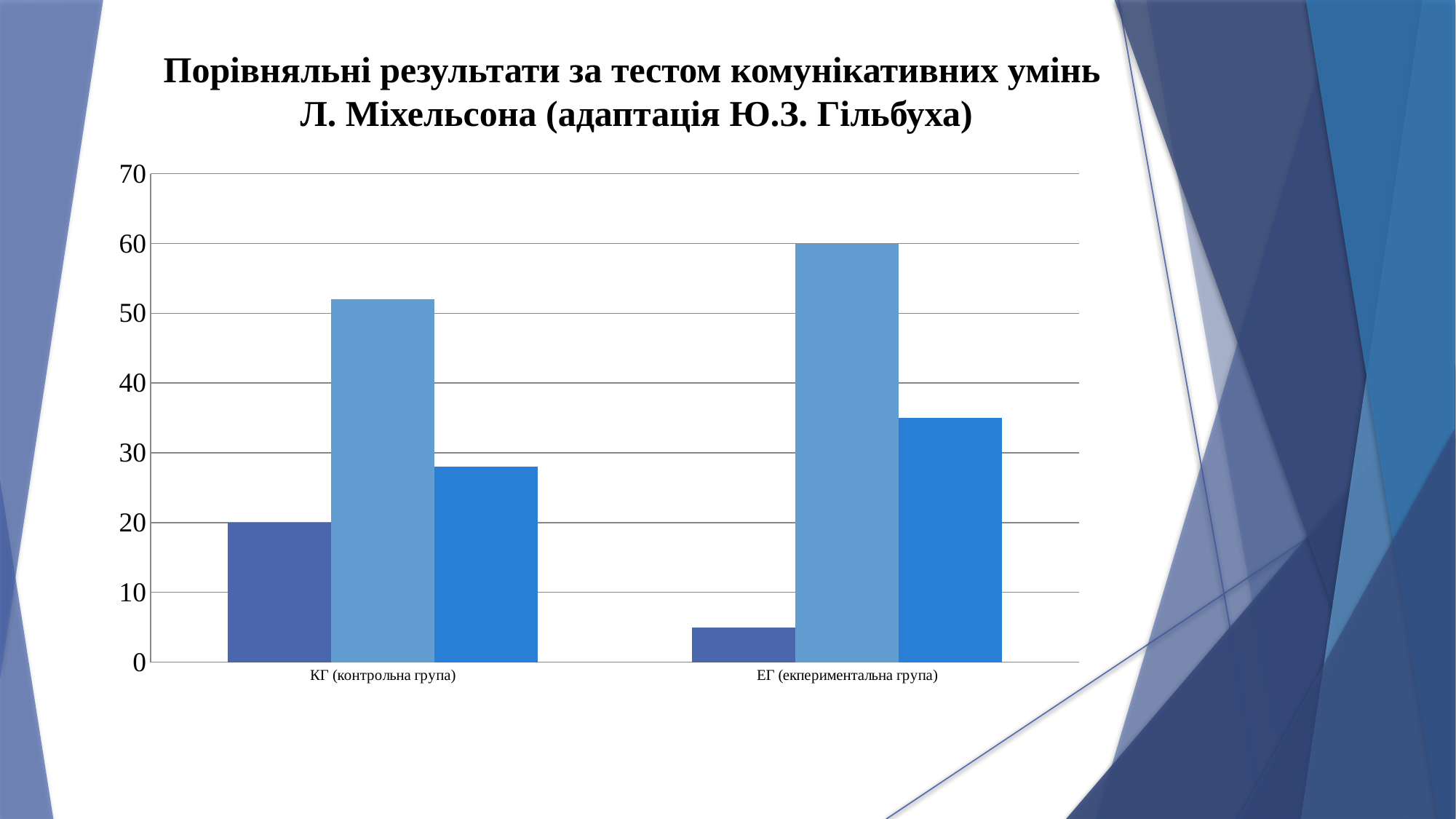
How many bars are plotted for each category in the chart? 3 What is the highest value shown on the vertical axis of the chart? 70 Which category has the larger value for the leftmost (dark blue) bar, КГ (контрольна група) or ЕГ (екпериментальна група)? КГ (контрольна група) What type of chart is shown on the slide? Bar chart Which category has the shortest bar in the chart? ЕГ (екпериментальна група) Is the value of the rightmost (bright blue) bar for ЕГ (екпериментальна група) greater or less than 30? greater What is the value of the leftmost (dark blue) bar for КГ (контрольна група)? 20 How many categories are shown on the x axis of the chart? 2 Which category has the tallest bar in the chart? ЕГ (екпериментальна група) What is the value of the middle (light blue) bar for ЕГ (екпериментальна група)? 60 Is the value of the leftmost (dark blue) bar for ЕГ (екпериментальна група) greater or less than 10? less Is the value of the middle (light blue) bar for КГ (контрольна група) greater or less than 50? greater